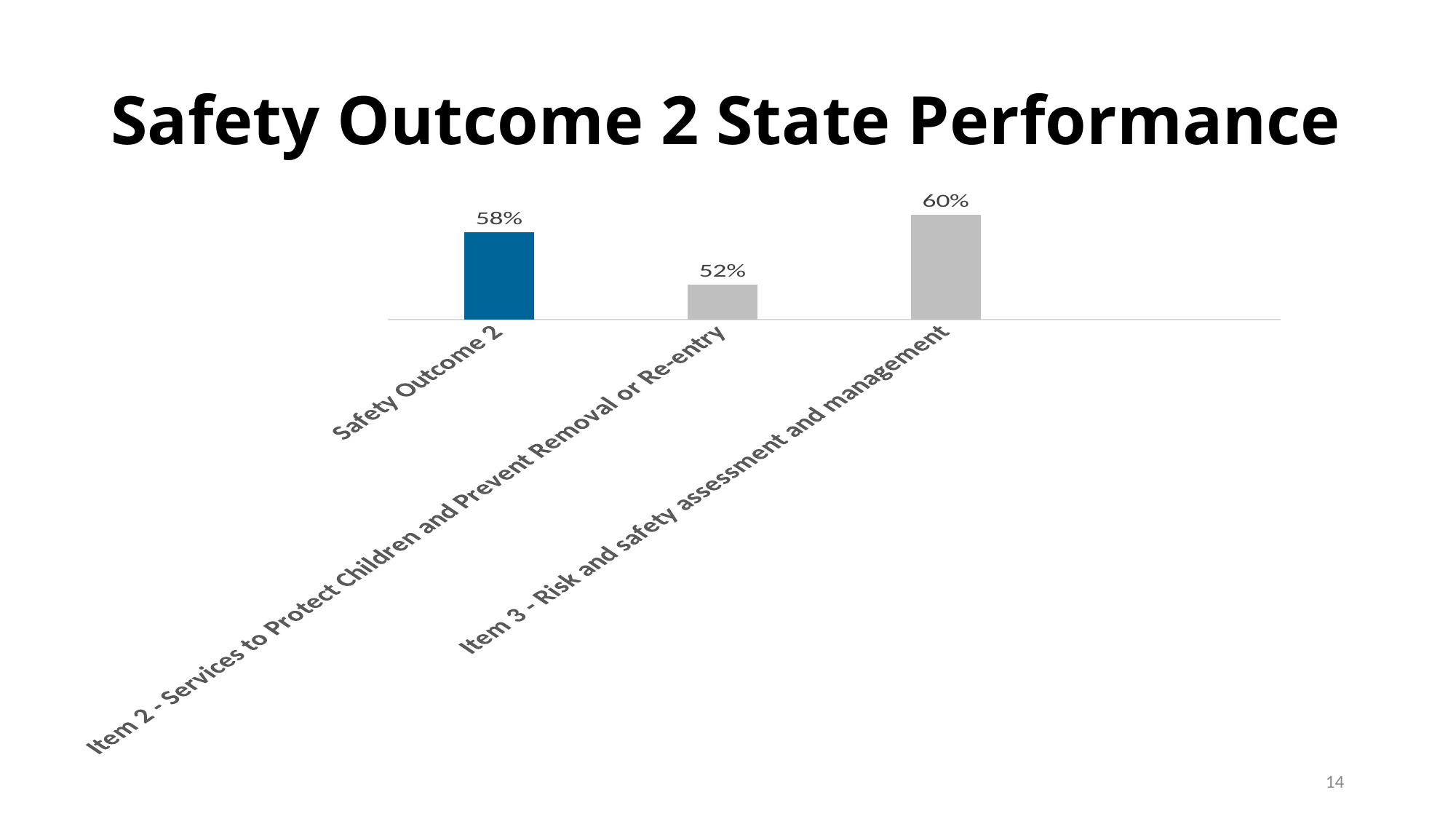
Which category has the highest value? Item 3 - Risk and safety assessment and management How many categories are shown in the chart? 3 Which category has the lowest value? Item 2 - Services to Protect Children and Prevent Removal or Re-entry What is the value for Item 3 - Risk and safety assessment and management? 60% What is the difference between the values for Item 3 and Item 2? 8% What is the difference between the values for Safety Outcome 2 and Item 2? 6% What kind of chart is shown on the slide? Bar chart What is the title of the slide? Safety Outcome 2 State Performance Which is larger, the value for Safety Outcome 2 or the value for Item 3? Item 3 Which bar is coloured blue rather than grey? Safety Outcome 2 What is the value for Safety Outcome 2? 58% What is the value for Item 2 - Services to Protect Children and Prevent Removal or Re-entry? 52%